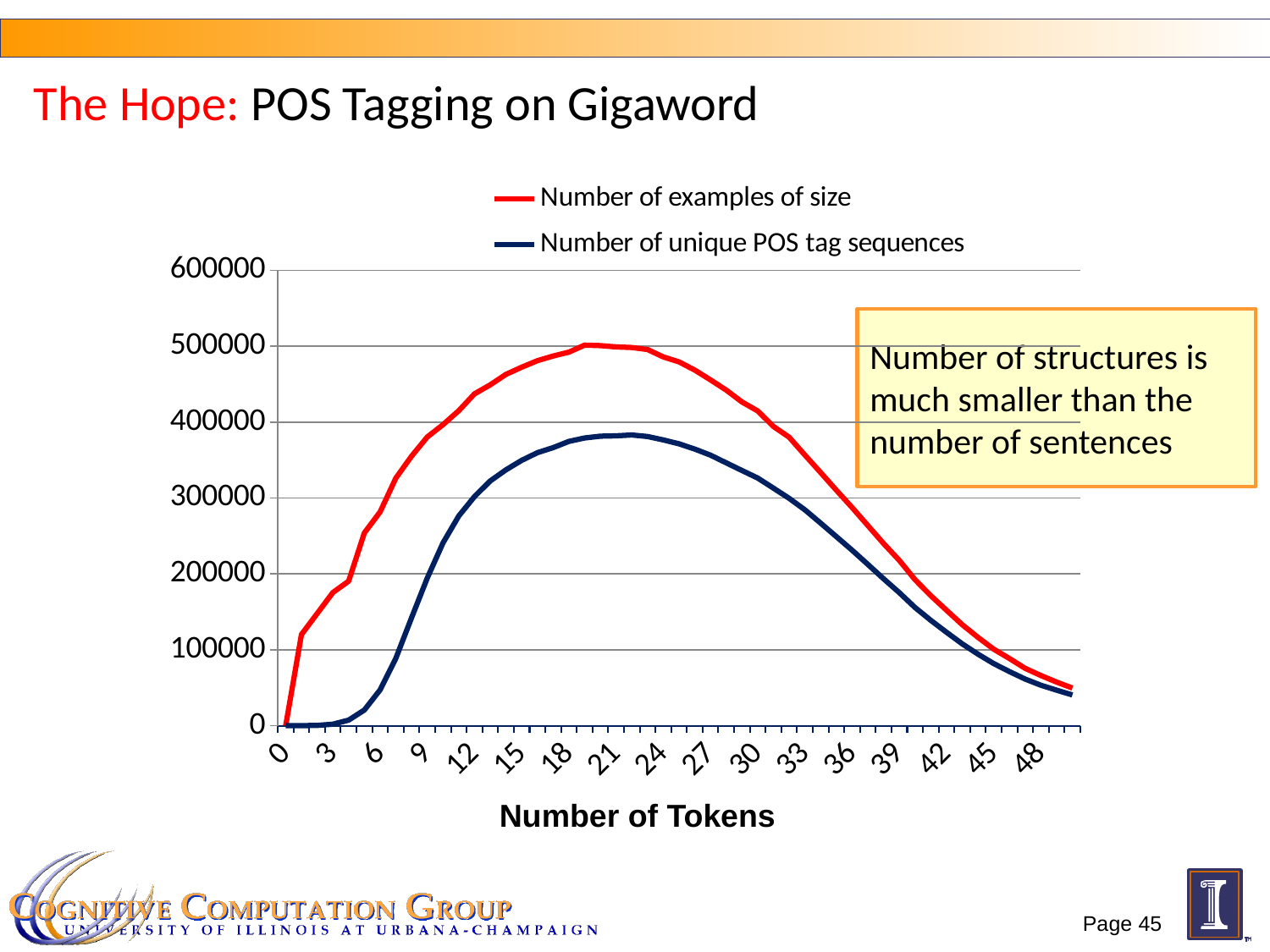
Which series reaches the higher peak value? Number of examples of size Is the value of "Number of unique POS tag sequences" at 21 tokens greater or less than 400000? less At 12 tokens, which series has the higher value? Number of examples of size What kind of chart is shown on the slide? line chart Is the value of "Number of examples of size" at 48 tokens greater or less than 100000? less Is the value of "Number of unique POS tag sequences" at 6 tokens greater or less than 100000? less Between 24 and 48 tokens, does the "Number of examples of size" line rise or fall? fall What colour is the line for "Number of examples of size"? red What is the title of the x axis? Number of Tokens How many series does the legend list? 2